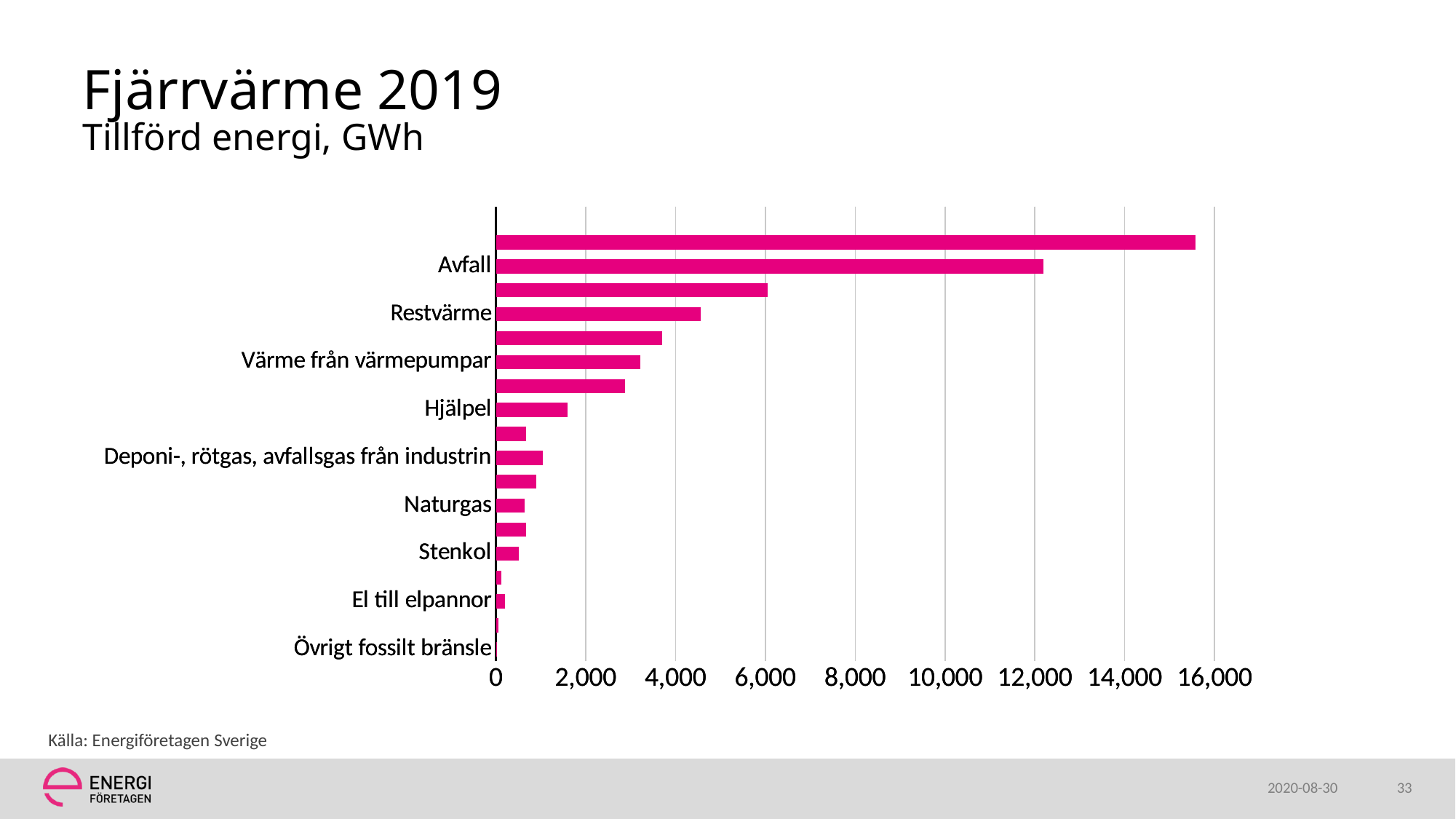
Is the value for Naturgas greater or less than 2,000? less Is the value for Värme från värmepumpar greater or less than 4,000? less Is the value for Avfall greater or less than 10,000? greater Which labelled category has the shortest bar? Övrigt fossilt bränsle Which is larger, the value for Avfall or the value for Restvärme? Avfall What is the source cited below the chart? Energiföretagen Sverige What kind of chart is shown on the slide? bar chart Which labelled category has the longest bar? Avfall Which is larger, the value for Hjälpel or the value for Stenkol? Hjälpel What unit is the energy measured in, according to the subtitle? GWh